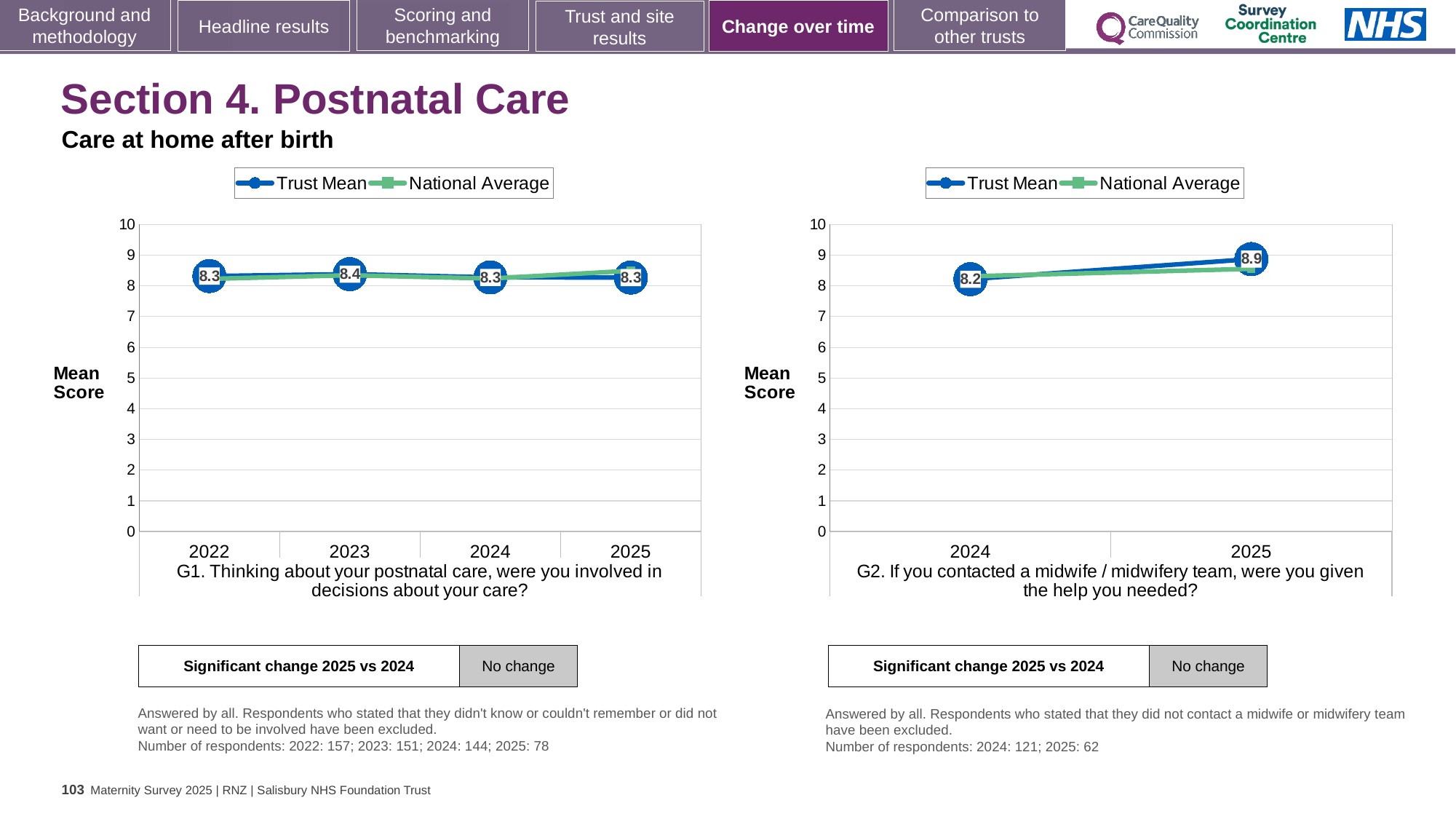
In the G2 chart on the right, what is the Trust Mean score for 2024? 8.2 What kind of chart is the G1 chart on the left? line chart In the G1 chart on the left, what is the Trust Mean score for 2025? 8.3 In the G1 chart on the left, is the National Average value for 2022 greater or less than 5? greater In the G1 chart on the left, which year has the highest Trust Mean score? 2023 In the G1 chart on the left, what is the Trust Mean score for 2023? 8.4 How many years are plotted on the x axis of the G1 chart on the left? 4 In the G2 chart on the right, what is the difference between the Trust Mean scores for 2025 and 2024? 0.7 How many series does the legend of the G2 chart on the right list? 2 In the G2 chart on the right, what is the Trust Mean score for 2025? 8.9 In the G2 chart on the right, does the Trust Mean rise or fall from 2024 to 2025? rise In the G2 chart on the right, is the Trust Mean score higher in 2024 or 2025? 2025